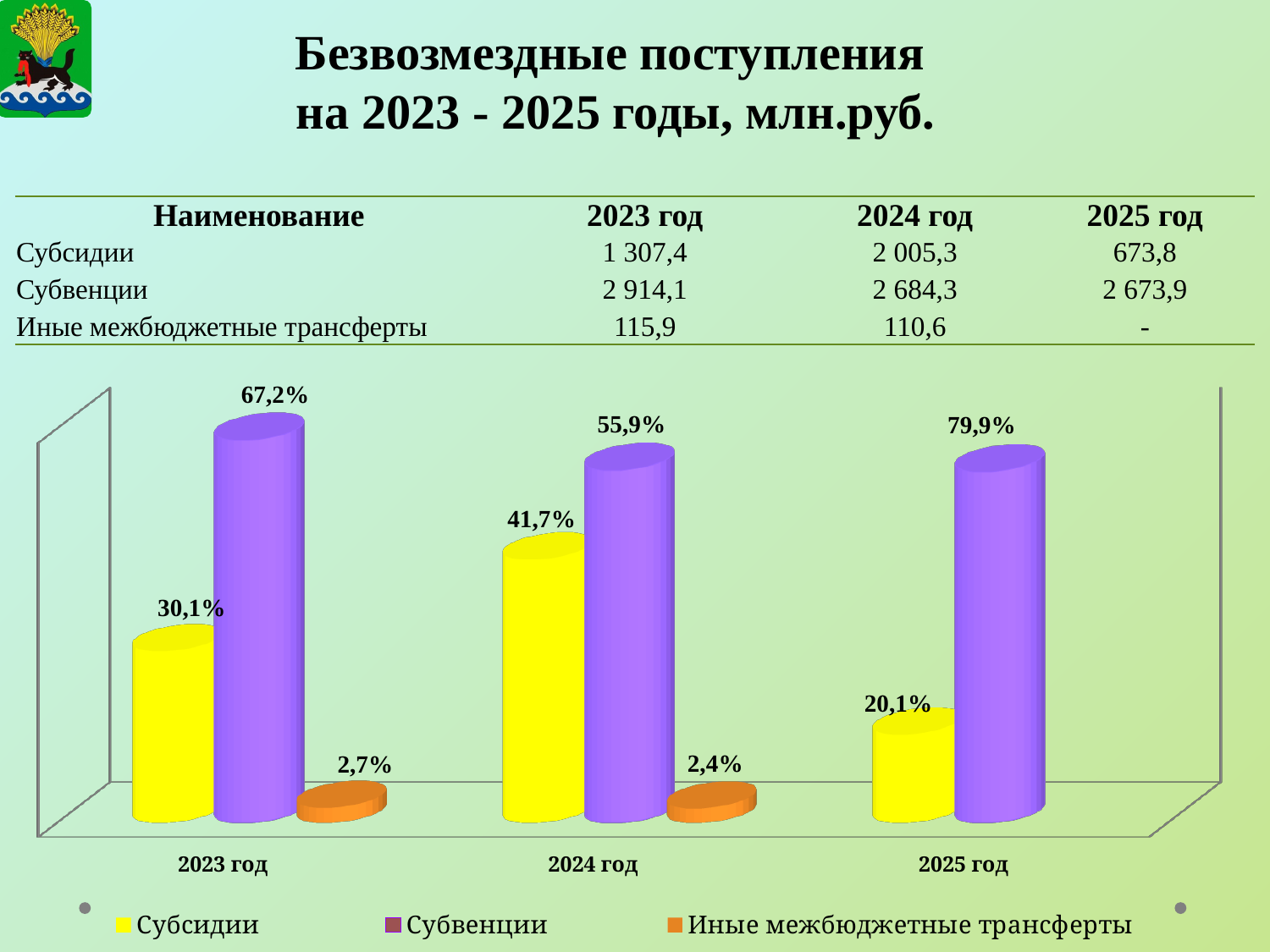
What is the value for Иные межбюджетные трансферты in 2024 год on the chart? 2,4% What is the value for Субсидии in 2025 год on the chart? 20,1% What kind of chart is shown on the slide? Bar chart What is the value for Субсидии in 2024 год on the chart? 41,7% What is the value for Субвенции in 2023 год on the chart? 67,2% How many year categories are shown on the x axis of the chart? 3 What is the difference between the Субвенции and Субсидии values in 2023 год on the chart? 37,1% In which year is the Субсидии share lowest on the chart? 2025 год How many series does the chart legend list? 3 In which year is the Субвенции share highest on the chart? 2025 год Which is larger on the chart: Субсидии in 2024 год or Субсидии in 2023 год? Субсидии in 2024 год What is the difference between the Субвенции and Субсидии values in 2025 год on the chart? 59,8%